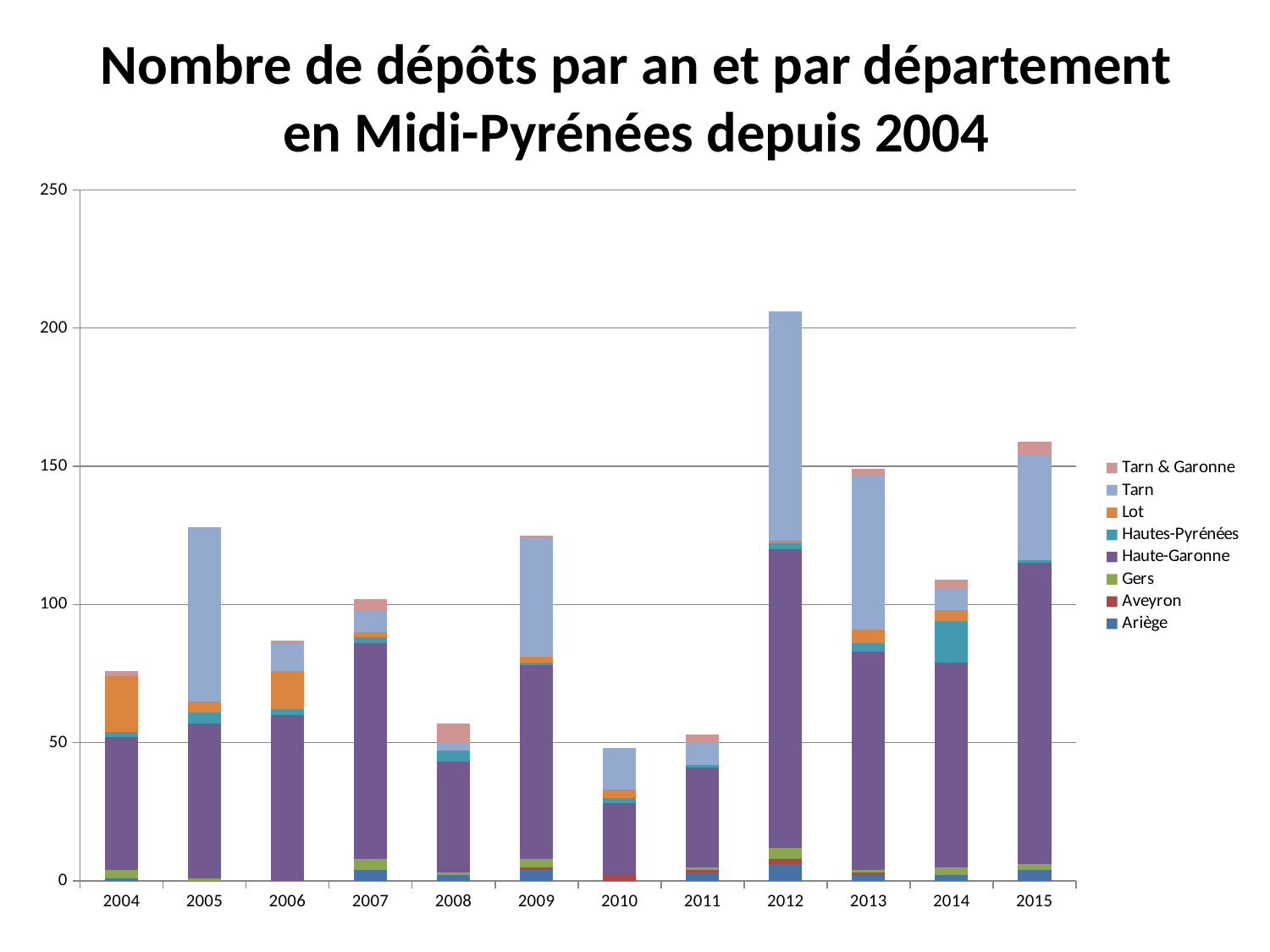
Is the total for 2012 greater or less than 200? greater Is the total for 2005 greater or less than 100? greater What kind of chart is shown on the slide? Stacked bar chart Which year has a larger total, 2005 or 2006? 2005 Is the total for 2015 greater or less than 150? greater Which series is listed at the bottom of the legend? Ariège Which year has a larger total, 2012 or 2013? 2012 How many years are shown along the x axis? 12 How many series does the legend list? 8 Which year has the highest total number of dépôts? 2012 Which year has the lowest total number of dépôts? 2010